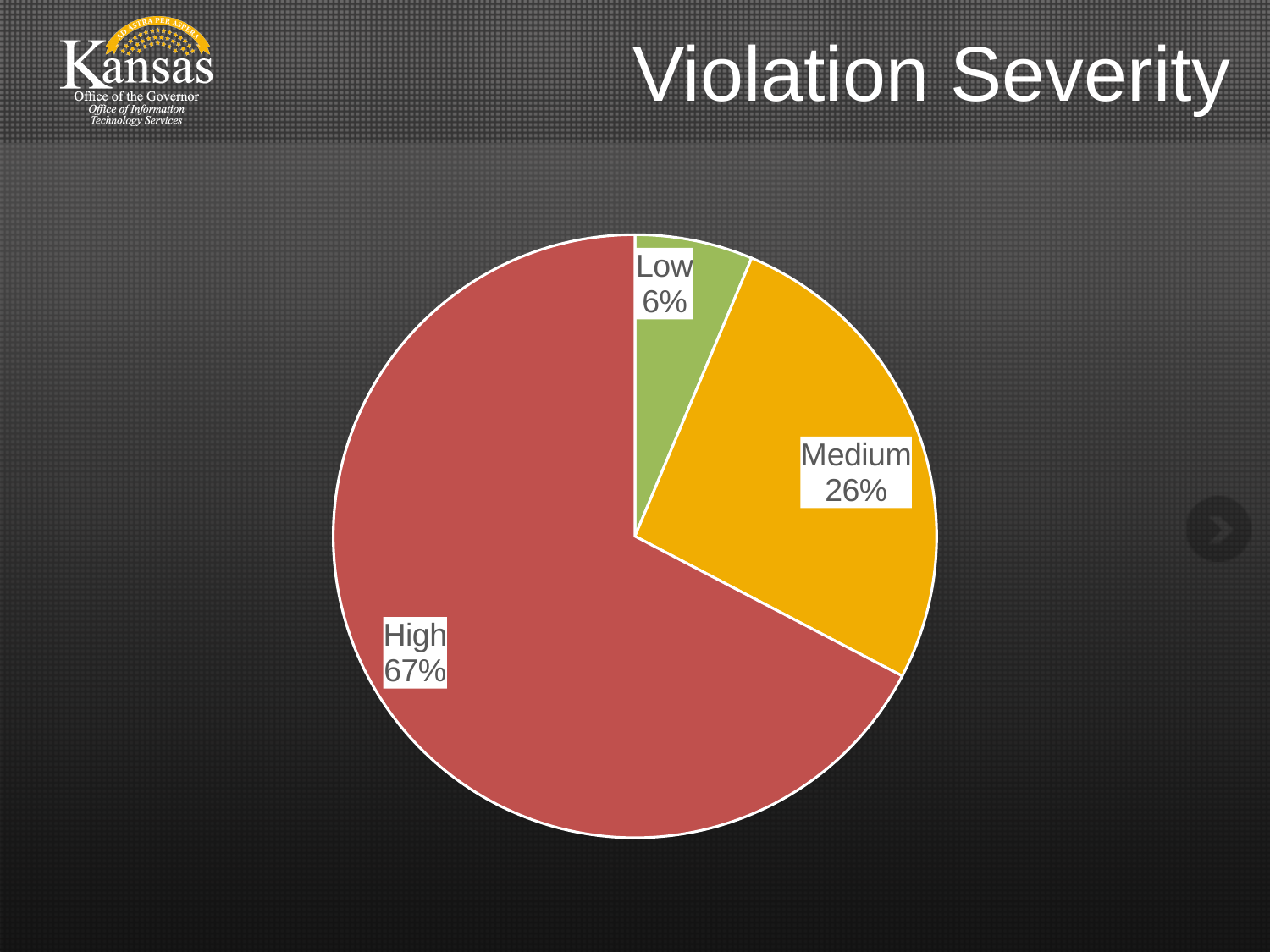
What percentage of violations are Low severity? 6% How many percentage points larger is the Medium share than the Low share? 20 What is the title of the slide containing the pie chart? Violation Severity Which severity category has the largest share of the pie? High How many slices does the pie chart have? 3 What percentage of violations are High severity? 67% What colour is the High slice of the pie chart? red How many percentage points larger is the High share than the Medium share? 41 What kind of chart is shown on the slide? pie chart Which severity category has the smallest share of the pie? Low What percentage of violations are Medium severity? 26% Which is larger, the Medium share or the Low share? Medium